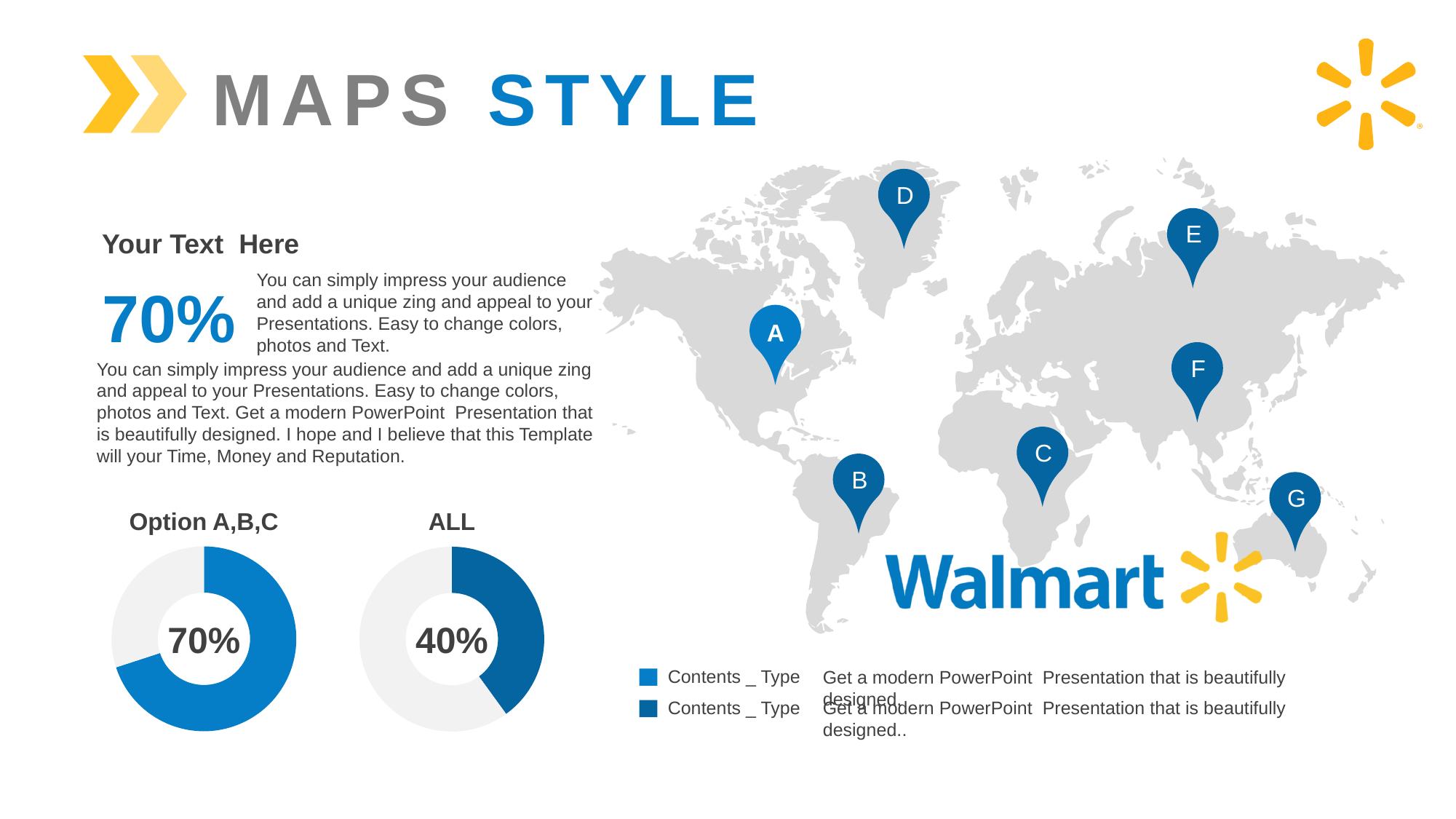
Which donut chart shows the higher percentage, "Option A,B,C" or "ALL"? Option A,B,C In the "ALL" donut chart, is the filled share greater or less than 50%? less What is the title of the donut chart on the left? Option A,B,C What value is shown in the centre of the "ALL" donut chart? 40% What is the title of the donut chart on the right? ALL In the "Option A,B,C" donut chart, is the filled share greater or less than 50%? greater How many donut charts are shown on the slide? 2 What kind of chart is used for "Option A,B,C" and "ALL"? Donut chart What value is shown in the centre of the "Option A,B,C" donut chart? 70% How many location markers are labelled on the world map? 7 What is the difference between the percentage in the "Option A,B,C" donut and the percentage in the "ALL" donut? 30%